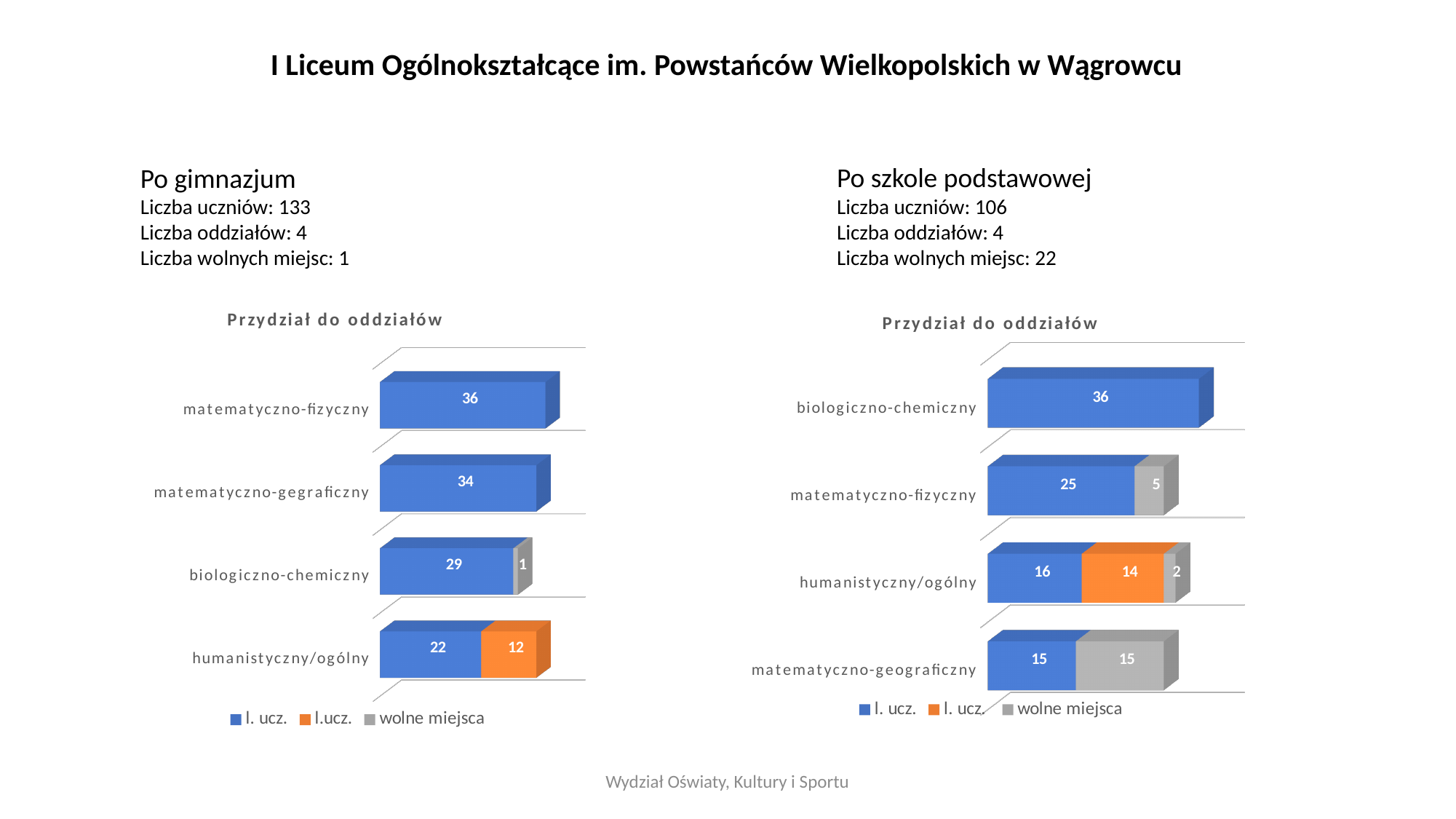
On the left chart (Po gimnazjum), how many wolne miejsca are shown for biologiczno-chemiczny? 1 On the right chart (Po szkole podstawowej), is the blue value for matematyczno-fizyczny larger or smaller than the blue value for humanistyczny/ogólny? larger How many categories are plotted on the left chart (Po gimnazjum)? 4 On the left chart (Po gimnazjum), which category has the highest blue 'l. ucz.' value? matematyczno-fizyczny On the left chart (Po gimnazjum), what is the value of the blue 'l. ucz.' series for matematyczno-fizyczny? 36 On the left chart (Po gimnazjum), what is the difference between the blue values for matematyczno-fizyczny and matematyczno-gegraficzny? 2 On the right chart (Po szkole podstawowej), how many wolne miejsca are shown for matematyczno-geograficzny? 15 On the right chart (Po szkole podstawowej), what is the value of the blue 'l. ucz.' series for biologiczno-chemiczny? 36 On the right chart (Po szkole podstawowej), which category has the lowest blue 'l. ucz.' value? matematyczno-geograficzny On the left chart (Po gimnazjum), what is the total of the stacked bar for humanistyczny/ogólny? 34 On the right chart (Po szkole podstawowej), what is the total of the stacked bar for humanistyczny/ogólny? 32 How many series does the legend of the right chart (Po szkole podstawowej) list? 3